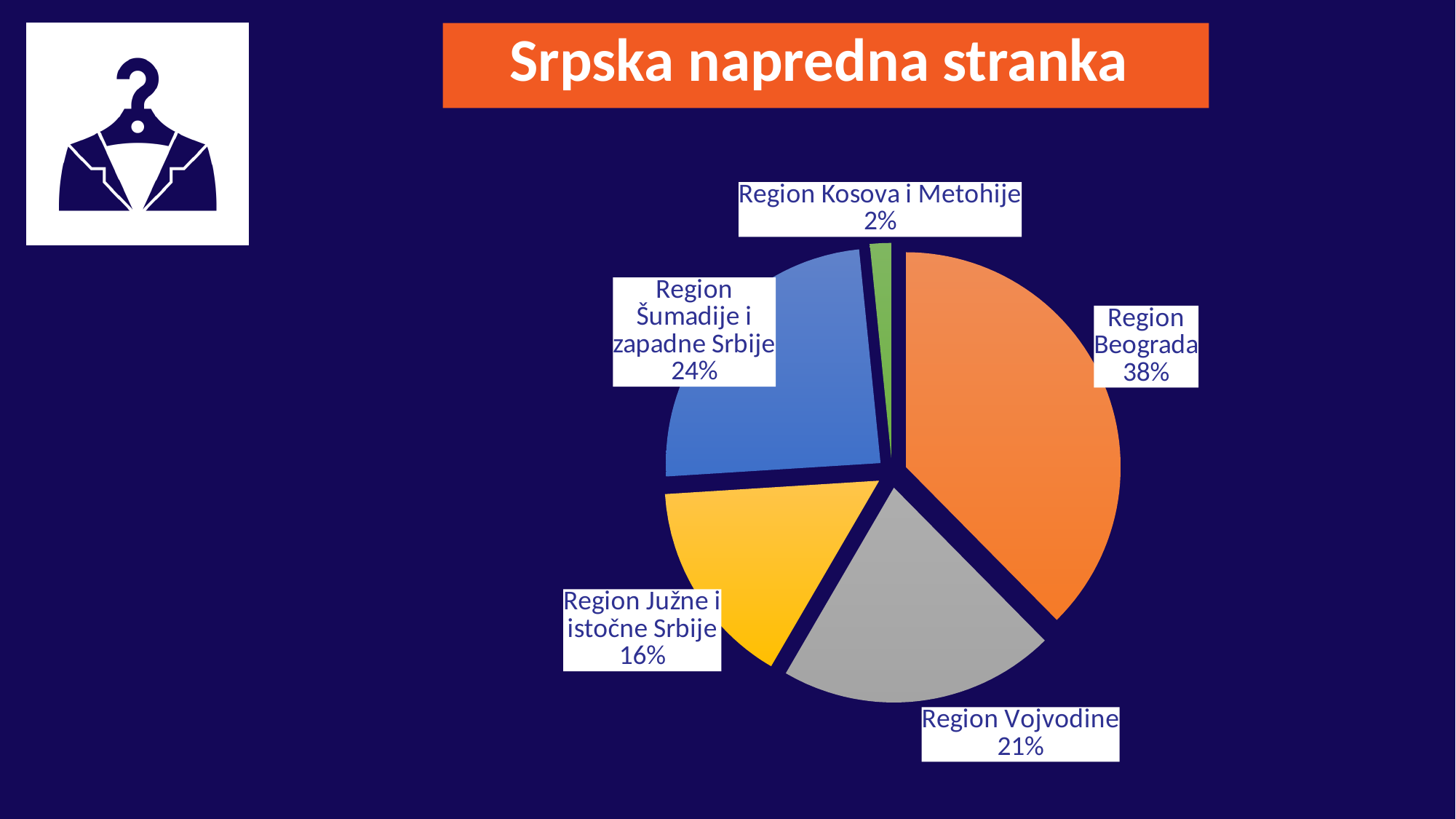
What kind of chart is shown on the slide? Pie chart What share of the pie does Region Beograda have? 38% What is the title shown above the chart? Srpska napredna stranka Which is larger, the share for Region Šumadije i zapadne Srbije or the share for Region Vojvodine? Region Šumadije i zapadne Srbije What share of the pie does Region Kosova i Metohije have? 2% What share of the pie does Region Južne i istočne Srbije have? 16% Which region has the smallest slice of the pie? Region Kosova i Metohije How many slices does the pie chart have? 5 Which region has the largest slice of the pie? Region Beograda What share of the pie does Region Šumadije i zapadne Srbije have? 24% What share of the pie does Region Vojvodine have? 21% What is the difference in percentage points between Region Beograda and Region Vojvodine? 17